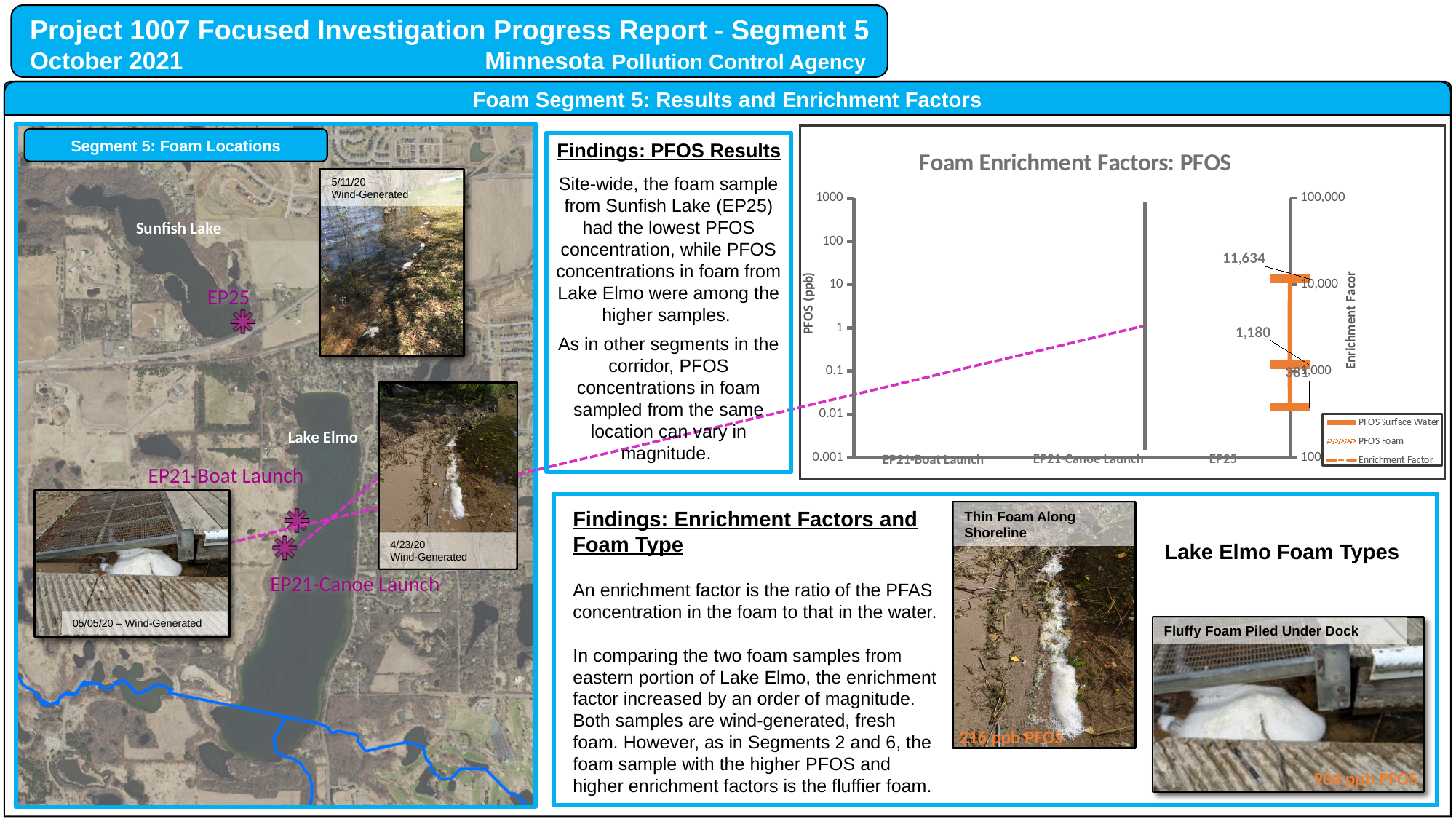
On the Foam Enrichment Factors: PFOS chart, what is the difference between the labeled enrichment factors 11,634 and 1,180? 10,454 What is the title of the chart on the slide? Foam Enrichment Factors: PFOS What is the highest tick value on the left PFOS (ppb) axis of the Foam Enrichment Factors: PFOS chart? 1000 What are the three series listed in the legend of the Foam Enrichment Factors: PFOS chart? PFOS Surface Water, PFOS Foam, Enrichment Factor What is the largest enrichment factor value labeled on the Foam Enrichment Factors: PFOS chart? 11,634 How many categories are shown on the x axis of the Foam Enrichment Factors: PFOS chart? 3 What is the smallest enrichment factor value labeled on the Foam Enrichment Factors: PFOS chart? 381 On the Foam Enrichment Factors: PFOS chart, which labeled enrichment factor is larger, 1,180 or 381? 1,180 Is the labeled enrichment factor of 11,634 on the Foam Enrichment Factors: PFOS chart greater or less than 10,000? greater How many series does the legend of the Foam Enrichment Factors: PFOS chart list? 3